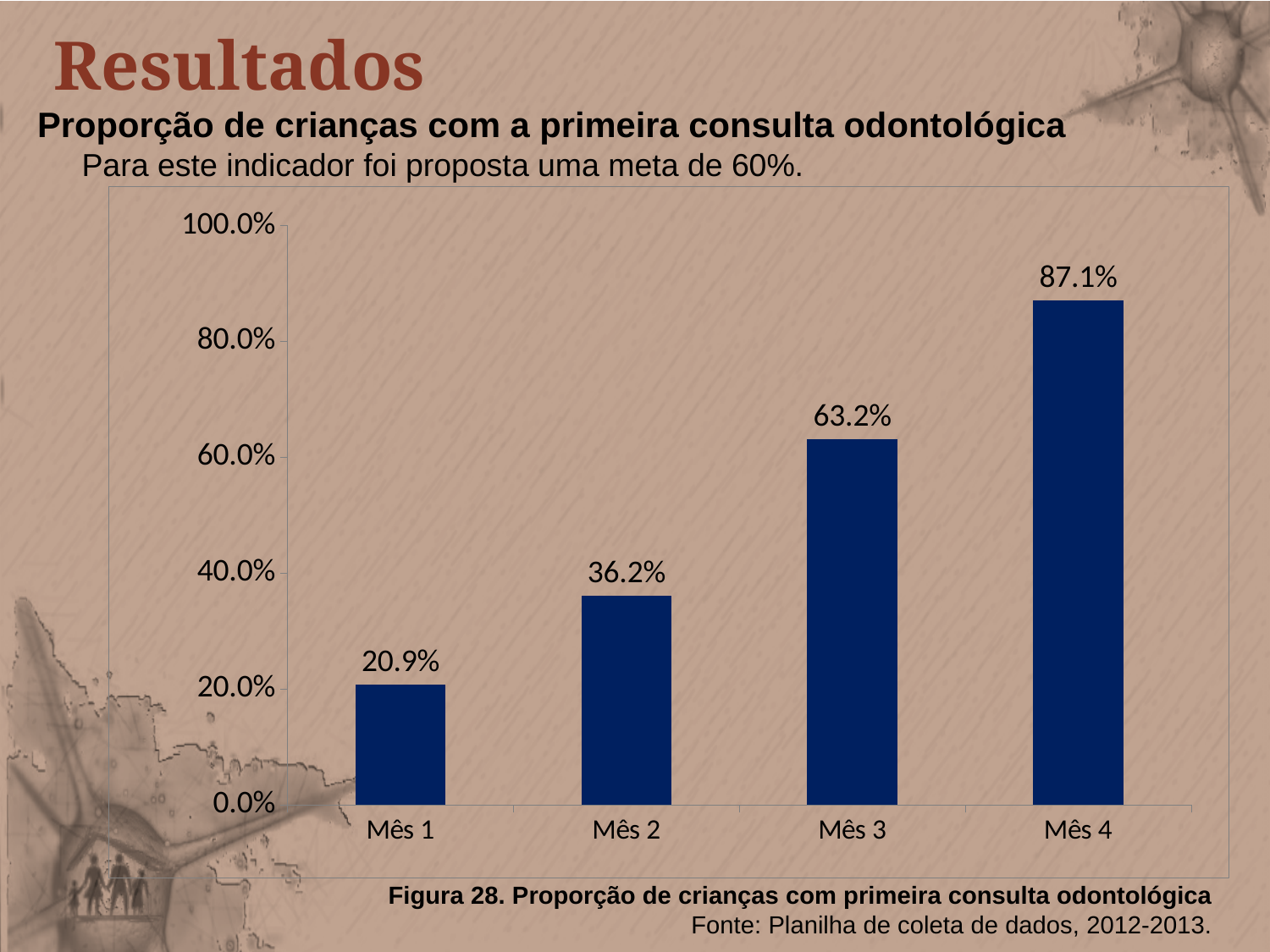
Which month has the lowest value? Mês 1 How many months are shown on the x axis? 4 What kind of chart is shown on the slide? bar chart What is the difference between the values for Mês 4 and Mês 3? 23.9% Do the values rise or fall from Mês 1 to Mês 4? rise Is the value for Mês 2 greater or less than 40.0%? less What is the value for Mês 1? 20.9% Which is larger, the value for Mês 2 or the value for Mês 3? Mês 3 What is the value for Mês 3? 63.2% What is the value for Mês 4? 87.1% What is the difference between the values for Mês 2 and Mês 1? 15.3% Which month has the highest value? Mês 4